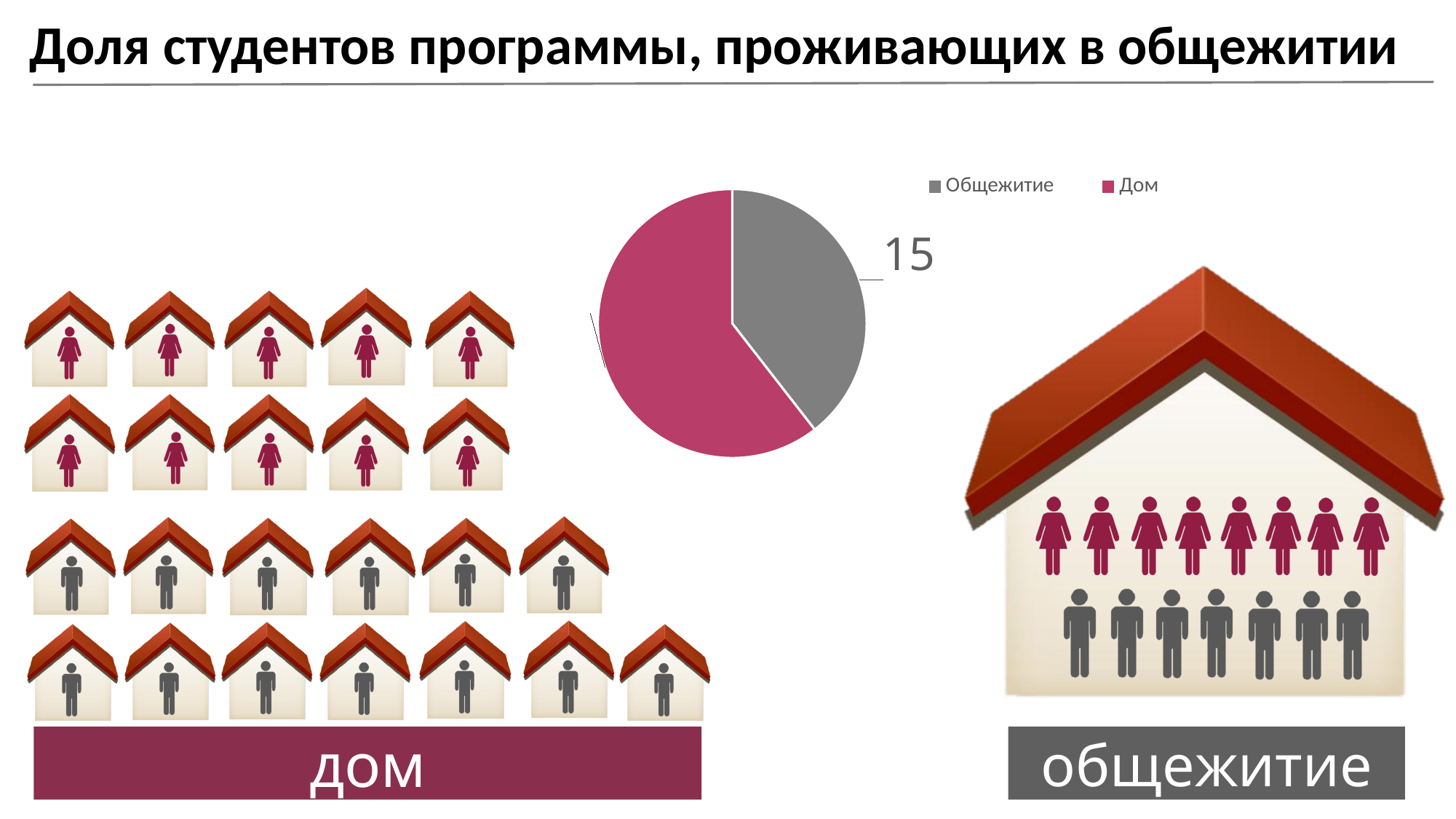
How many slices does the pie chart have? 2 Which is larger in the pie chart, Дом or Общежитие? Дом What is the title of the slide containing the pie chart? Доля студентов программы, проживающих в общежитии What value is printed for the Общежитие slice of the pie chart? 15 What kind of chart is shown on the slide? pie chart How many entries does the legend of the pie chart list? 2 What colour is the Общежитие slice in the pie chart? grey Which slice of the pie chart is the largest? Дом Which slice of the pie chart is the smallest? Общежитие